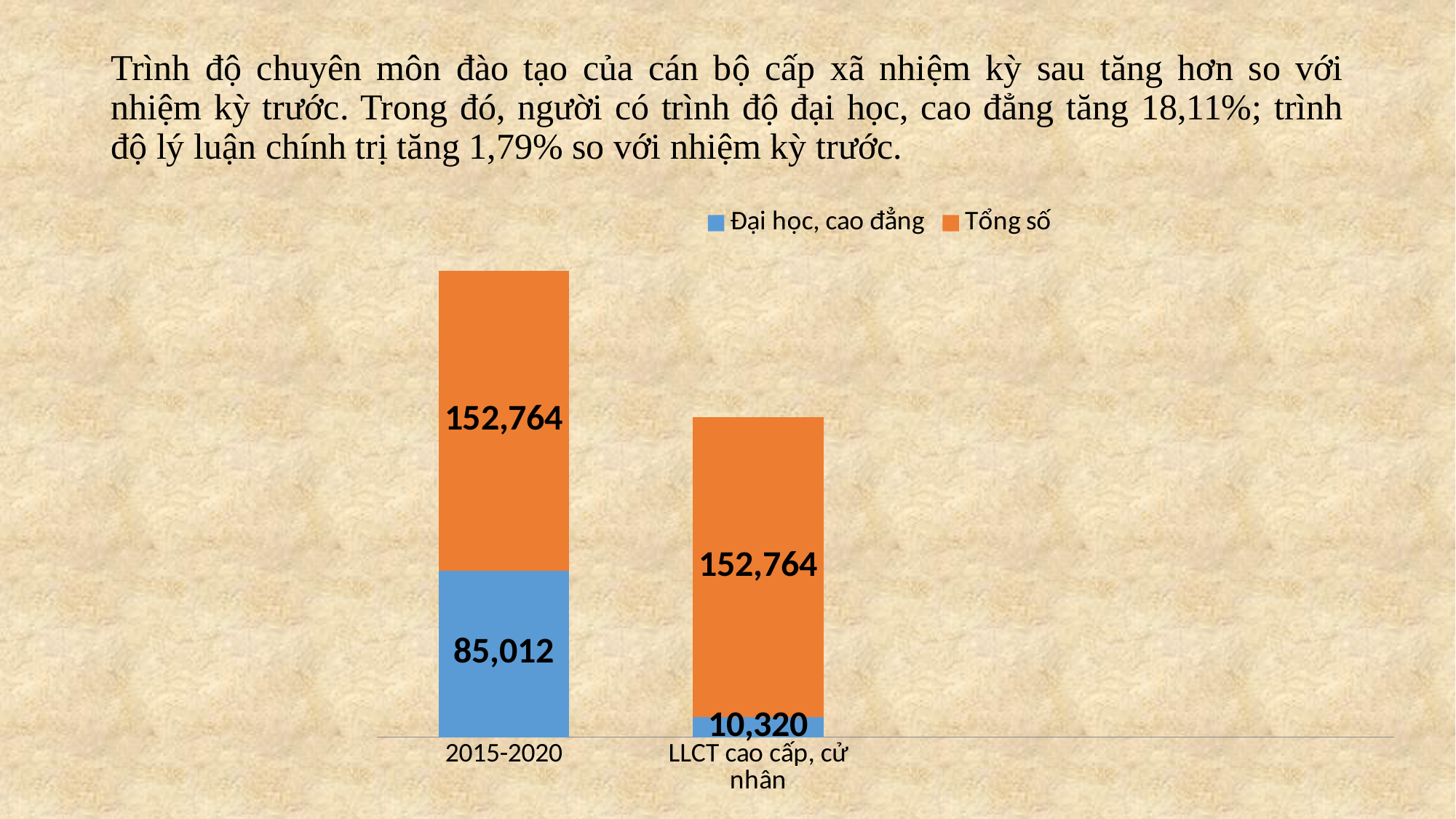
What is the difference between the Đại học, cao đẳng values for 2015-2020 and LLCT cao cấp, cử nhân? 74,692 What is the value of Tổng số for LLCT cao cấp, cử nhân? 152,764 What is the total of the stacked bar for LLCT cao cấp, cử nhân? 163,084 Which category has the lower Đại học, cao đẳng value? LLCT cao cấp, cử nhân What is the value of Tổng số for 2015-2020? 152,764 What is the total of the stacked bar for 2015-2020? 237,776 How many categories are shown on the x axis? 2 Is the Đại học, cao đẳng value for 2015-2020 larger or smaller than the Đại học, cao đẳng value for LLCT cao cấp, cử nhân? larger Which category has the higher Đại học, cao đẳng value? 2015-2020 What is the value of Đại học, cao đẳng for 2015-2020? 85,012 What is the value of Đại học, cao đẳng for LLCT cao cấp, cử nhân? 10,320 How many series does the legend list? 2